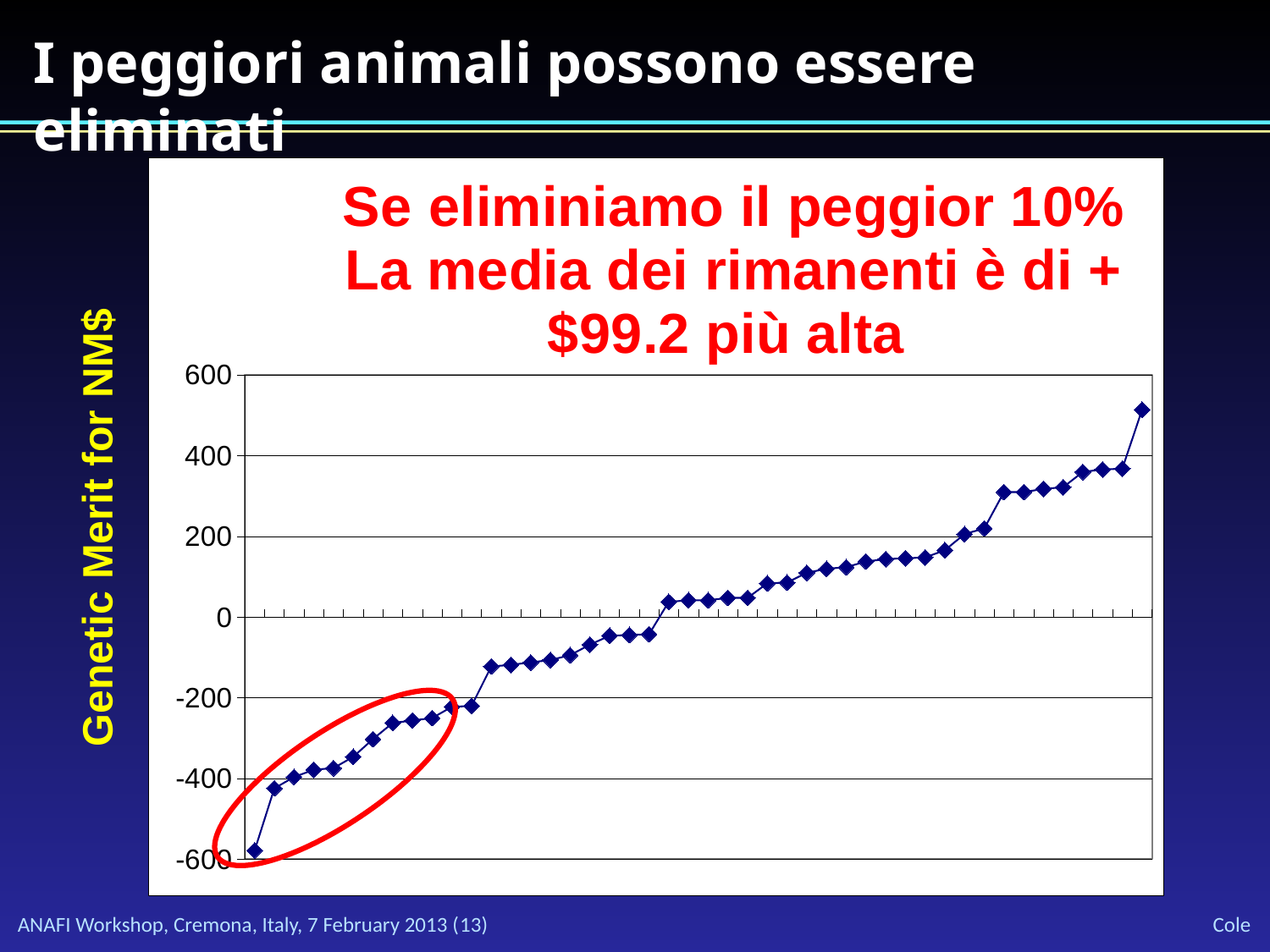
Which is larger, the value of the leftmost point or the value of the rightmost point? the rightmost point Is the value of the highest point greater or less than 600? less What is the label of the vertical axis of the chart? Genetic Merit for NM$ What kind of chart is shown on the slide? line chart Do the plotted values rise or fall from left to right along the x axis? rise Is the value of the leftmost (lowest) point greater or less than -400? less What is the lowest tick value shown on the vertical axis? -600 What is the highest tick value shown on the vertical axis? 600 Are the points inside the red ellipse greater or less than -200? less How many data series are plotted on the chart? 1